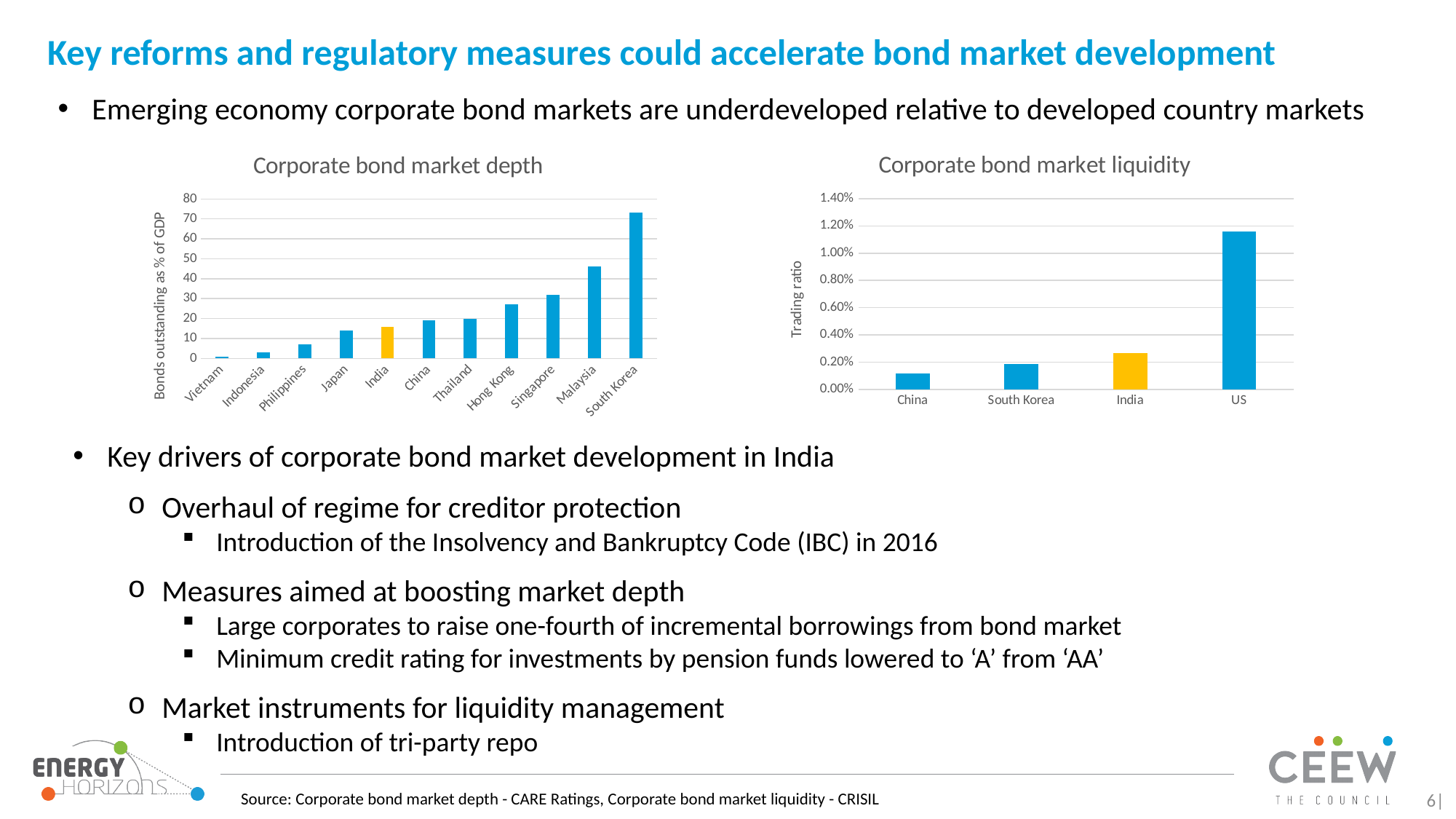
In the 'Corporate bond market liquidity' chart, which country has the highest trading ratio? US In the 'Corporate bond market depth' chart, do the values rise or fall moving from left to right along the x axis? rise What kind of chart is the 'Corporate bond market liquidity' chart? bar chart In the 'Corporate bond market depth' chart, is the value for South Korea greater or less than 70? greater How many countries are shown in the 'Corporate bond market depth' chart? 11 In the 'Corporate bond market depth' chart, which is larger, the value for Singapore or the value for Hong Kong? Singapore In the 'Corporate bond market depth' chart, is the value for Malaysia greater or less than 40? greater In the 'Corporate bond market liquidity' chart, which country has the lowest trading ratio? China What is the y-axis label of the 'Corporate bond market depth' chart? Bonds outstanding as % of GDP In the 'Corporate bond market depth' chart, which country has the lowest value? Vietnam In the 'Corporate bond market liquidity' chart, is the value for US greater or less than 1.00%? greater In the 'Corporate bond market depth' chart, which country has the highest value? South Korea